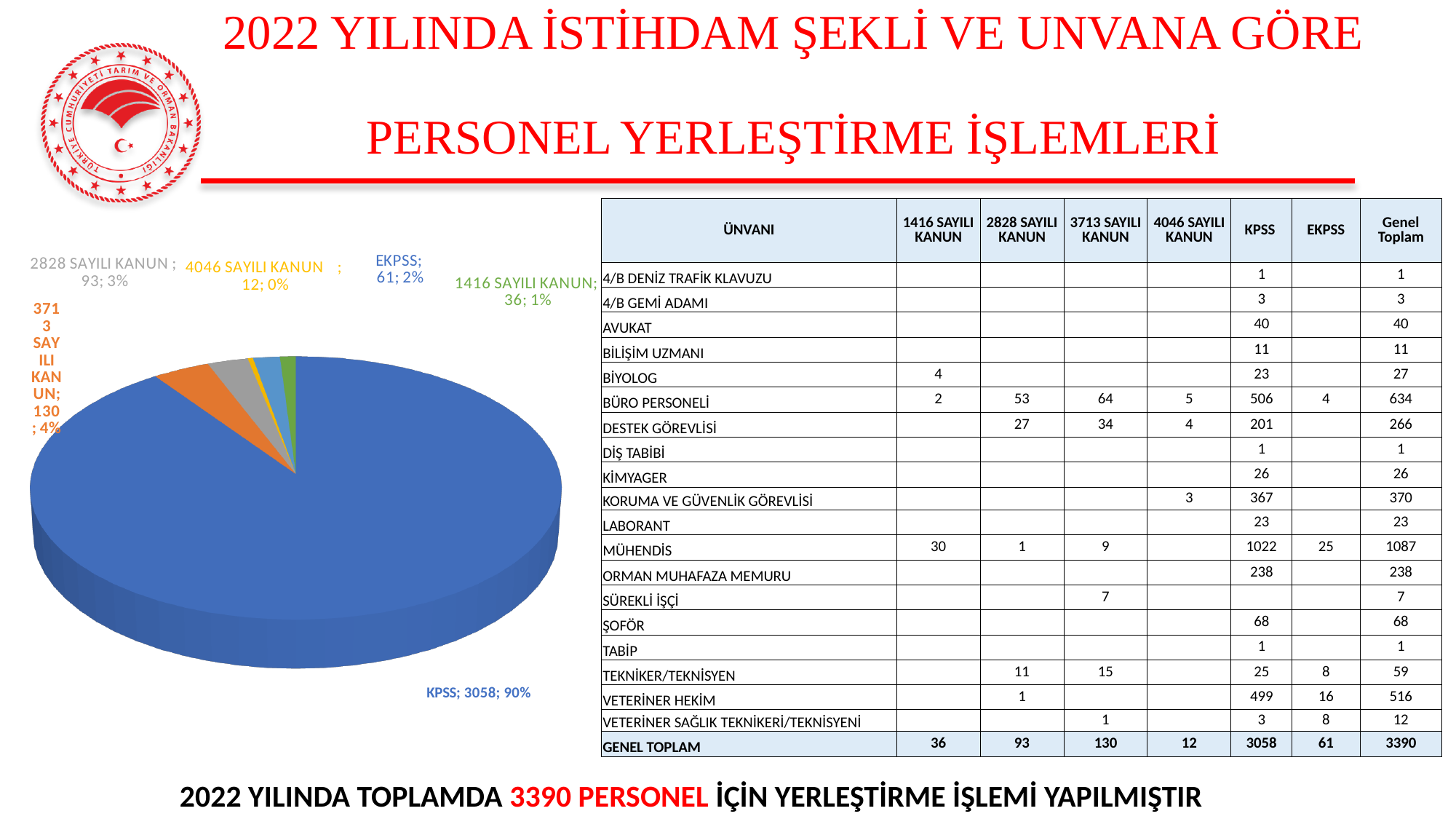
What percentage share does 1416 SAYILI KANUN have in the pie chart? 1% How many slices does the pie chart have? 6 What percentage share does KPSS have in the pie chart? 90% What is the value shown for EKPSS in the pie chart? 61 Which category has the smallest slice in the pie chart? 4046 SAYILI KANUN What percentage share does 3713 SAYILI KANUN have in the pie chart? 4% What is the value shown for KPSS in the pie chart? 3058 Which is larger in the pie chart, the value for EKPSS or the value for 1416 SAYILI KANUN? EKPSS What is the difference between the values for 3713 SAYILI KANUN and 2828 SAYILI KANUN in the pie chart? 37 Which category has the largest slice in the pie chart? KPSS What kind of chart is shown on the left of the slide? pie chart What is the value shown for 2828 SAYILI KANUN in the pie chart? 93